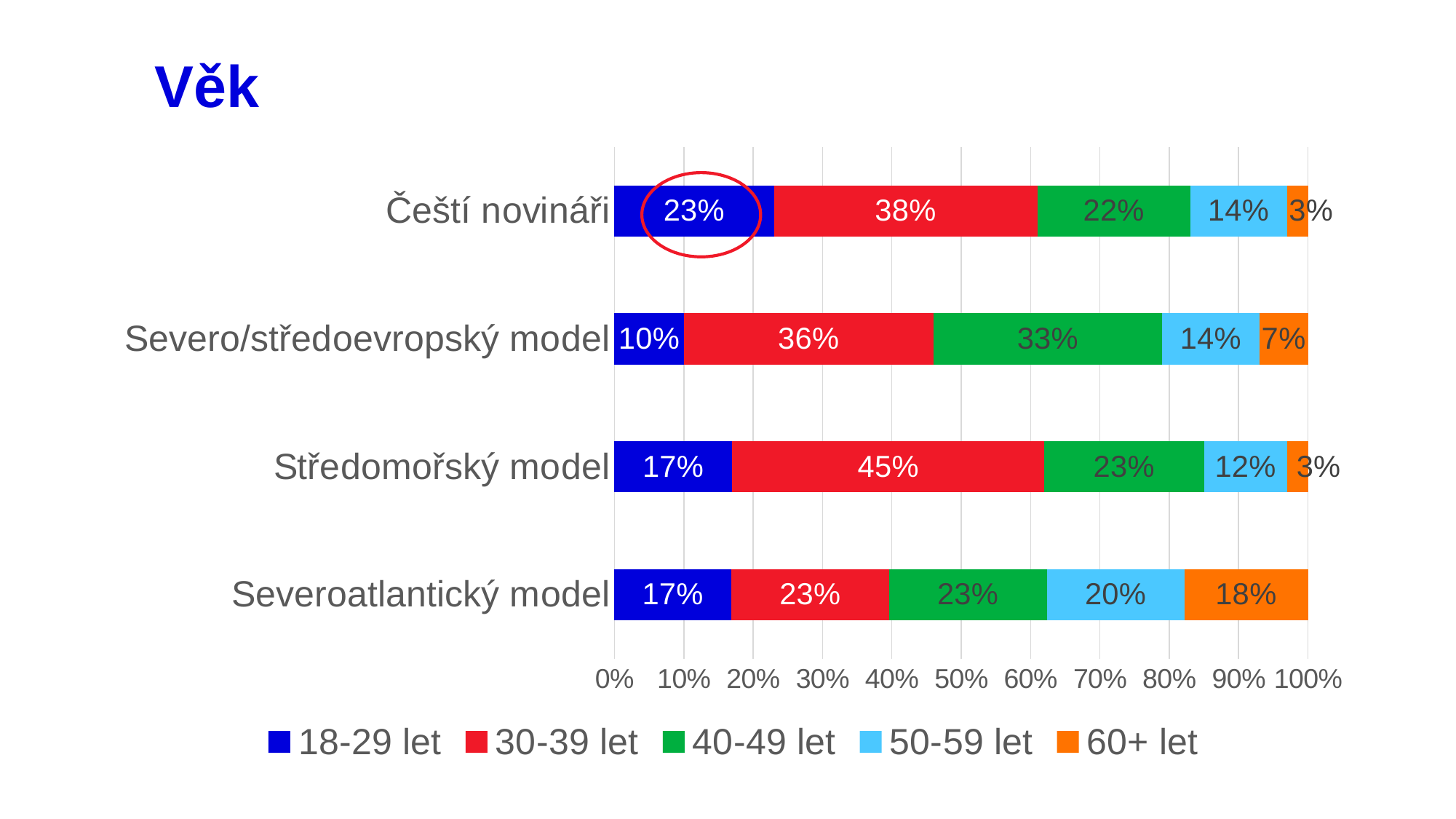
What share of the Středomořský model is 30-39 let? 45% What percentage of Čeští novináři are aged 18-29 let? 23% What kind of chart is shown on the slide? Stacked bar chart What is the value for 40-49 let in the Severo/středoevropský model? 33% What is the title of the slide? Věk Which is larger: the 60+ let value for the Severoatlantický model or for the Severo/středoevropský model? Severoatlantický model What is the value for 60+ let in the Severoatlantický model? 18% Which category has the highest value for 30-39 let? Středomořský model What is the difference between the 18-29 let values for Čeští novináři and the Severo/středoevropský model? 13% Which category has the lowest value for 18-29 let? Severo/středoevropský model How many categories are shown on the y axis? 4 How many series does the legend list? 5